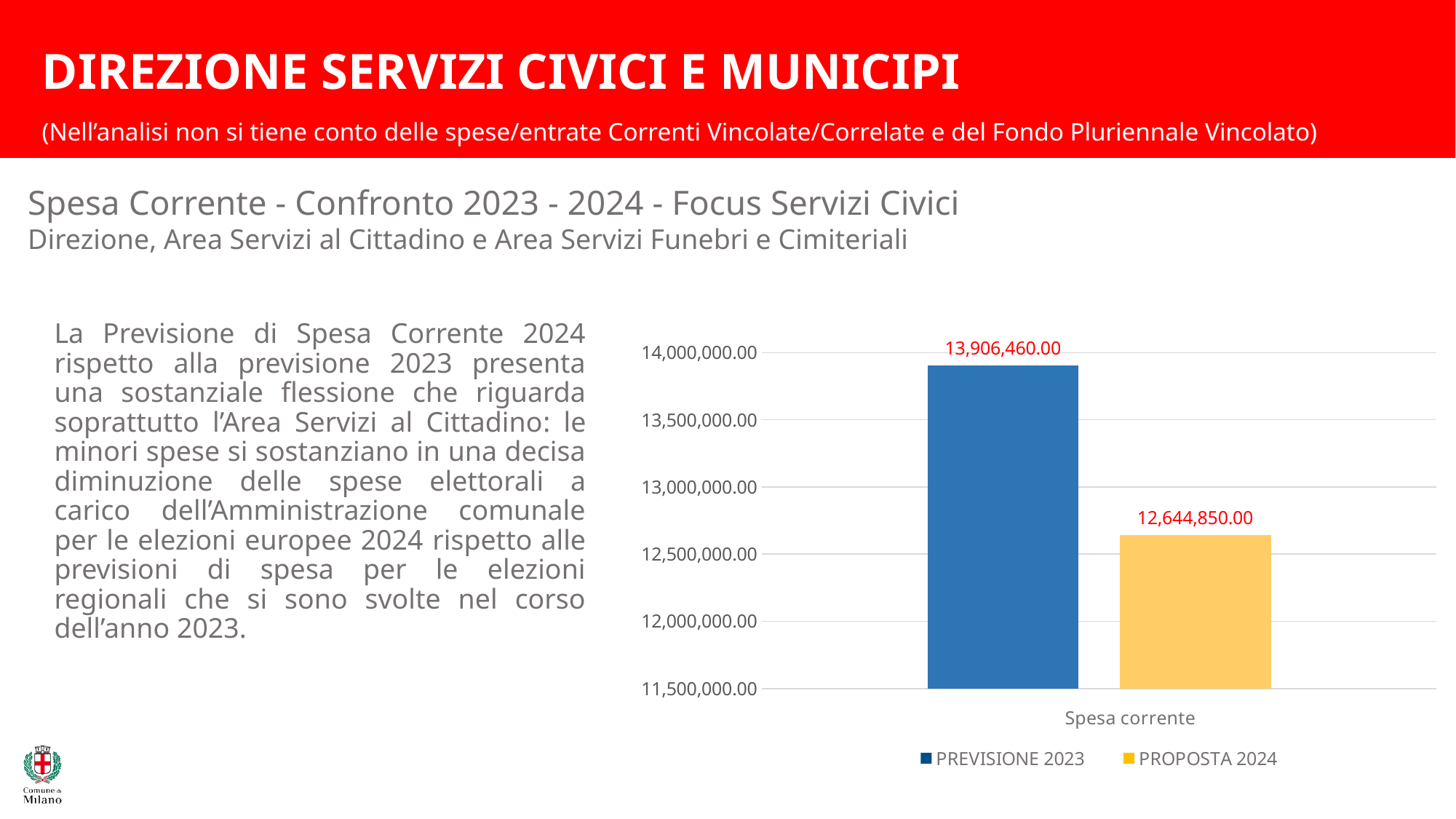
Which series has the lowest value in the chart? PROPOSTA 2024 What is the category label shown on the x axis of the chart? Spesa corrente What is the difference between the PREVISIONE 2023 value and the PROPOSTA 2024 value? 1,261,610.00 Is the value for PROPOSTA 2024 greater or less than 13,000,000.00? less How many categories are shown on the x axis of the chart? 1 Which colour represents PROPOSTA 2024 in the chart? Yellow What is the value for PREVISIONE 2023 in the chart? 13,906,460.00 What is the value for PROPOSTA 2024 in the chart? 12,644,850.00 What kind of chart is shown on the slide? Bar chart Which series has the higher value, PREVISIONE 2023 or PROPOSTA 2024? PREVISIONE 2023 Is the value for PREVISIONE 2023 greater or less than 13,500,000.00? greater How many series does the legend list? 2